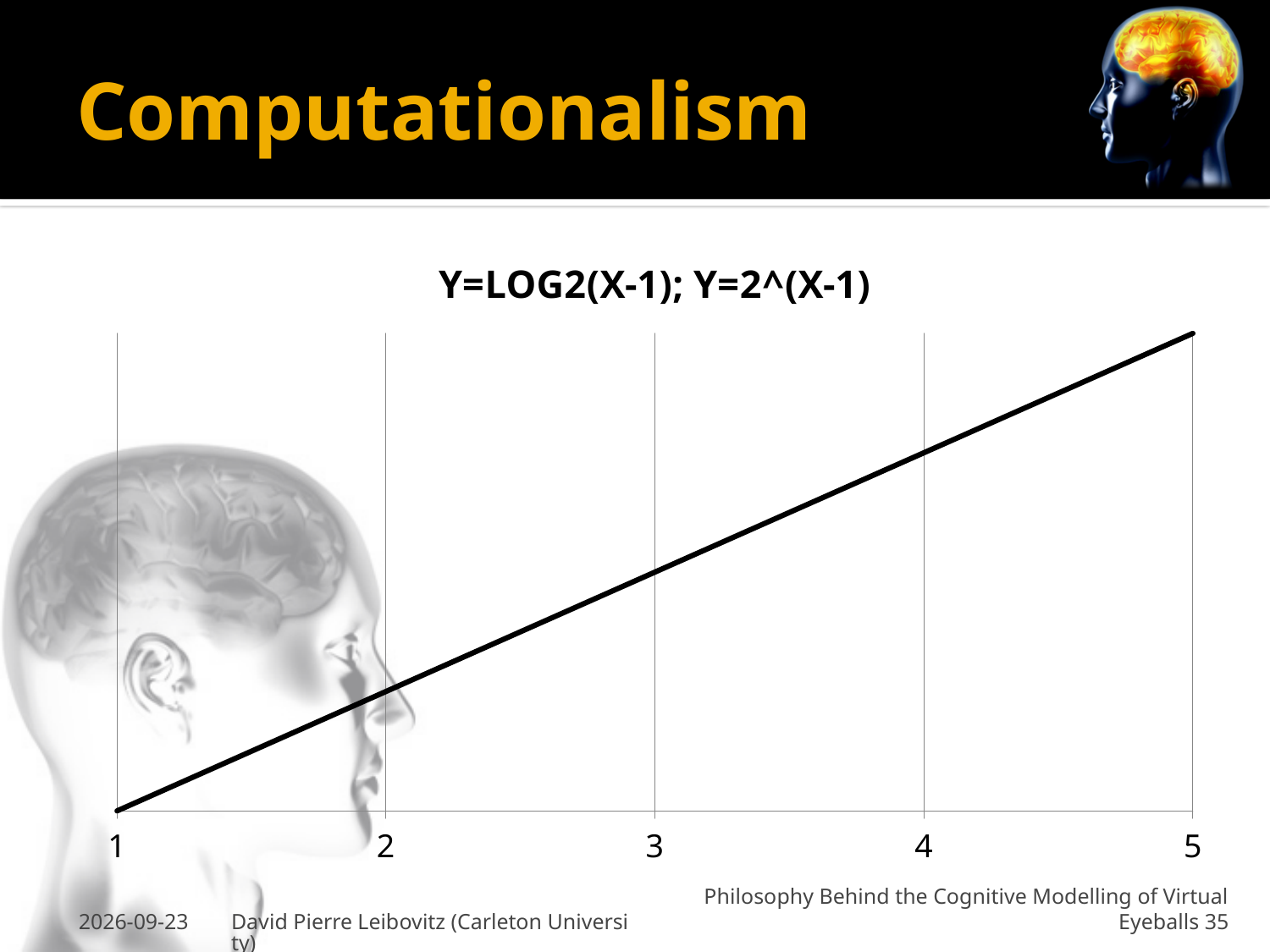
How many tick labels are shown on the x axis of the chart? 5 At which x-axis value does the line reach its highest point? 5 Is the plotted value at X=4 larger or smaller than the value at X=2? larger What is the smallest x-axis tick label shown on the chart? 1 What kind of chart is shown on the slide? line chart Is the plotted value at X=3 larger or smaller than the value at X=5? smaller At which x-axis value does the line reach its lowest point? 1 Do the plotted values rise or fall as X increases from 1 to 5? rise What is the title of the chart? Y=LOG2(X-1); Y=2^(X-1)